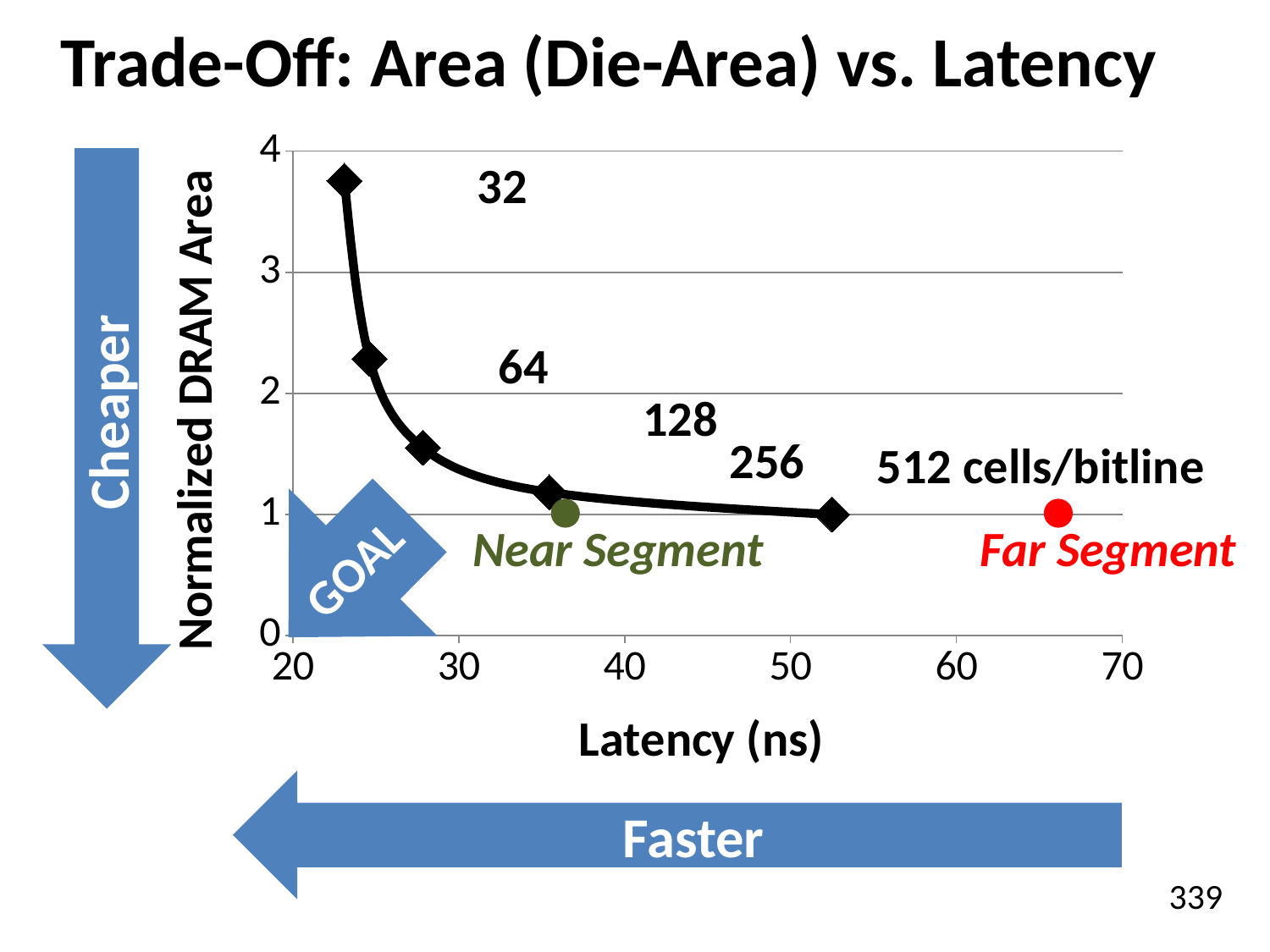
What kind of chart is shown on the slide? line chart Is the normalized DRAM area for 32 cells/bitline greater or less than 3? greater How many cells/bitline data points are plotted on the black curve? 5 Which cells/bitline configuration has the highest normalized DRAM area? 32 What is the title of the slide's chart? Trade-Off: Area (Die-Area) vs. Latency As latency increases along the x axis, does the normalized DRAM area rise or fall? fall Is the normalized DRAM area for 128 cells/bitline greater or less than 2? less What is the label of the x axis? Latency (ns) Which cells/bitline configuration has the lowest normalized DRAM area? 256 and 512 (both at 1) Is the latency of the Far Segment point greater or less than 60 ns? greater Which has the larger latency, the Near Segment point or the Far Segment point? Far Segment